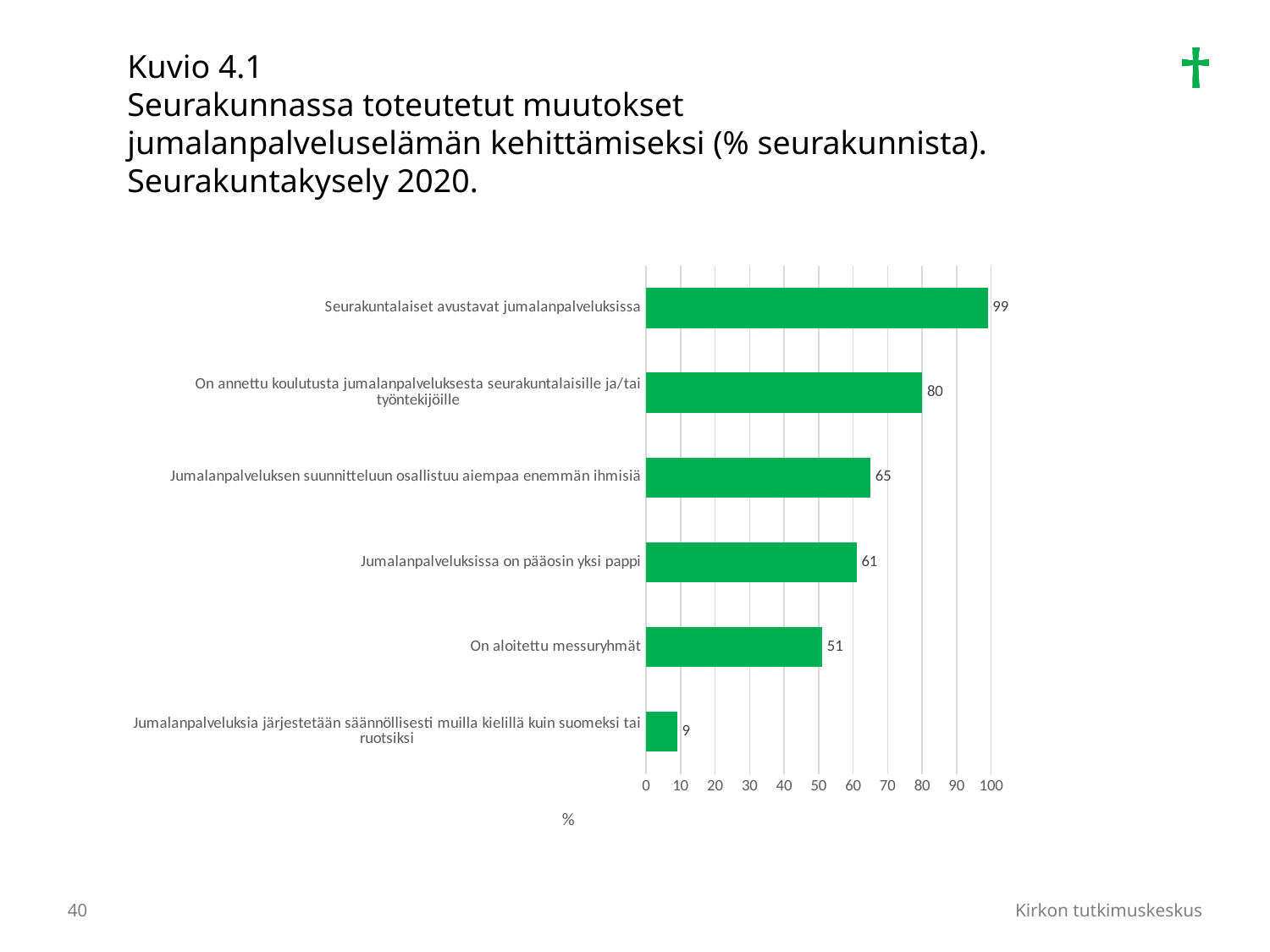
What is the difference between the values for "Seurakuntalaiset avustavat jumalanpalveluksissa" and "On annettu koulutusta jumalanpalveluksesta seurakuntalaisille ja/tai työntekijöille"? 19 How many categories are shown in the chart? 6 What is the value for "On aloitettu messuryhmät"? 51 Which category has the highest value? Seurakuntalaiset avustavat jumalanpalveluksissa What unit is shown on the horizontal axis label? % What kind of chart is shown on the slide? Bar chart Which category has the lowest value? Jumalanpalveluksia järjestetään säännöllisesti muilla kielillä kuin suomeksi tai ruotsiksi Which is larger: the value for "Jumalanpalveluksen suunnitteluun osallistuu aiempaa enemmän ihmisiä" or for "Jumalanpalveluksissa on pääosin yksi pappi"? Jumalanpalveluksen suunnitteluun osallistuu aiempaa enemmän ihmisiä What is the value for "On annettu koulutusta jumalanpalveluksesta seurakuntalaisille ja/tai työntekijöille"? 80 What is the value for "Jumalanpalveluksissa on pääosin yksi pappi"? 61 What is the value for "Seurakuntalaiset avustavat jumalanpalveluksissa"? 99 What is the difference between the values for "Jumalanpalveluksen suunnitteluun osallistuu aiempaa enemmän ihmisiä" and "On aloitettu messuryhmät"? 14